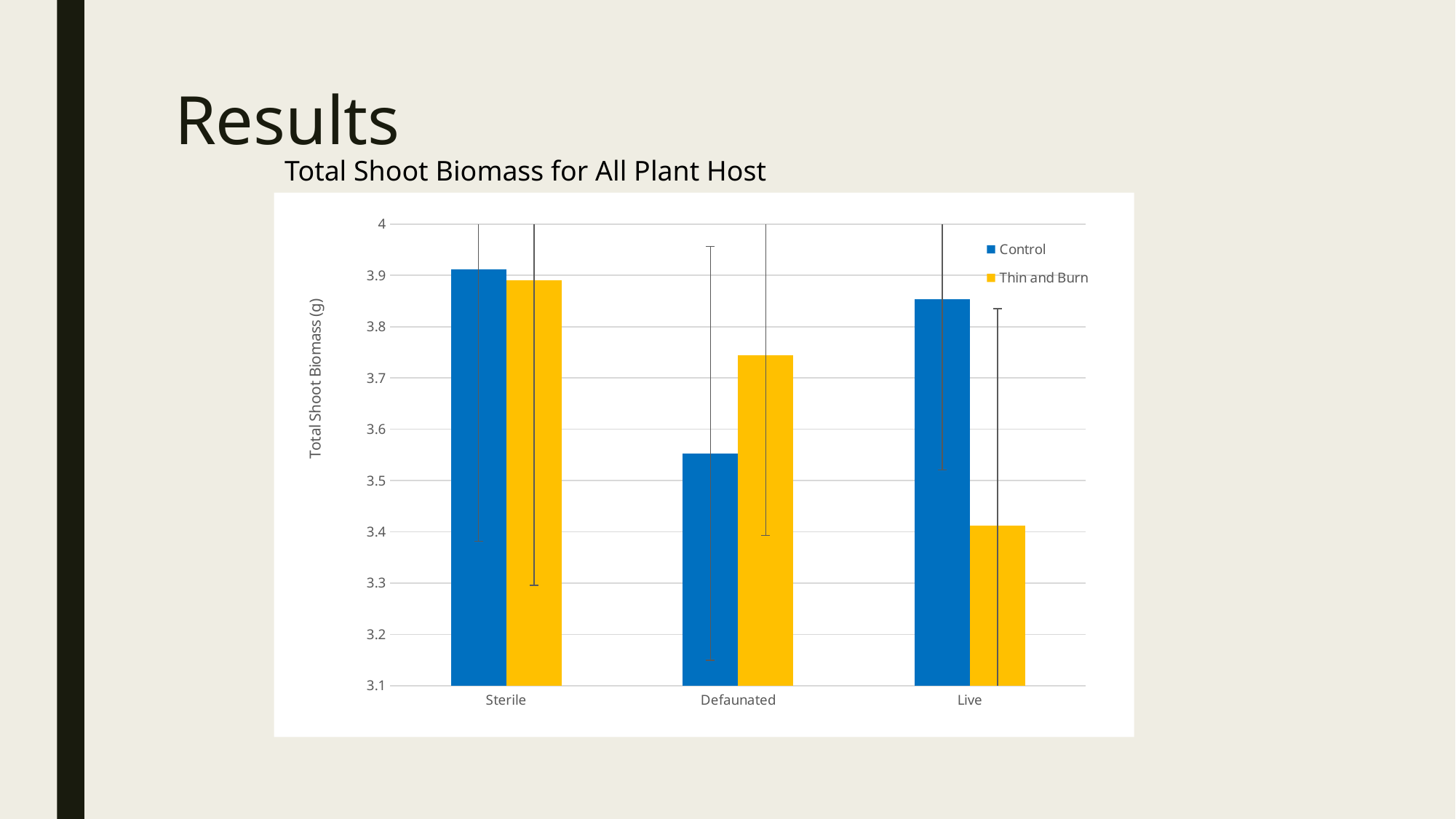
Which category has the highest Thin and Burn value? Sterile How many series does the legend list? 2 How many categories are shown on the x axis? 3 What is the title of the chart? Total Shoot Biomass for All Plant Host Is the Control value for Defaunated greater or less than 3.6? less Which category has the lowest Control value? Defaunated For Live, which is larger: Control or Thin and Burn? Control For Defaunated, which is larger: Control or Thin and Burn? Thin and Burn What is the label of the vertical axis? Total Shoot Biomass (g) Is the Thin and Burn value for Live greater or less than 3.5? less Which category has the lowest Thin and Burn value? Live What type of chart is shown on the slide? bar chart